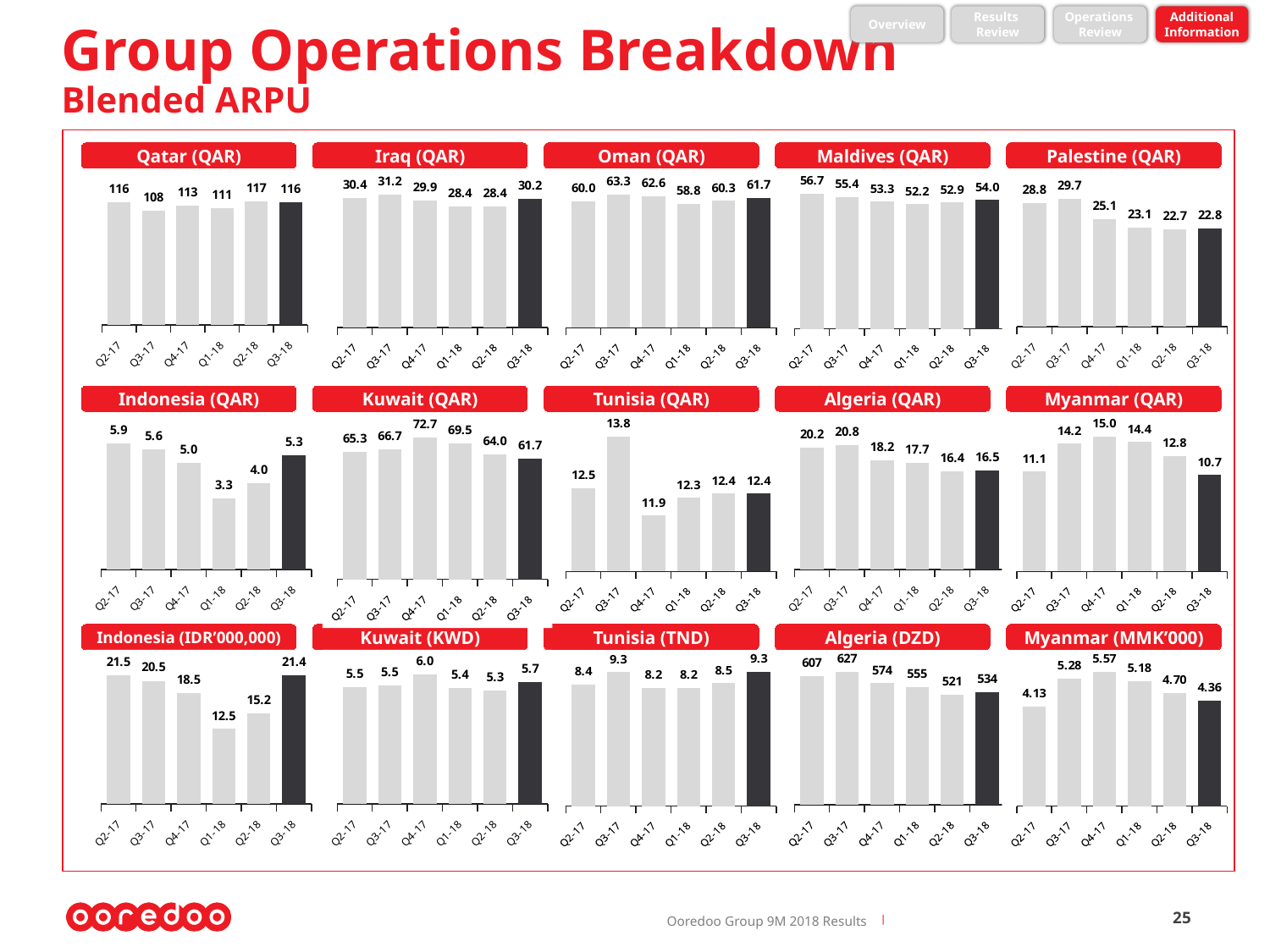
How many quarters are plotted in the Maldives (QAR) chart? 6 In the Tunisia (QAR) chart, what is the difference between the Q3-17 value and the Q4-17 value? 1.9 In the Indonesia (QAR) chart, which quarter has the lowest value? Q1-18 In the Qatar (QAR) chart, what is the value for Q2-18? 117 In the Myanmar (MMK'000) chart, what is the value for Q4-17? 5.57 What type of chart is the Oman (QAR) chart? bar chart In the Palestine (QAR) chart, is the value for Q3-17 larger or smaller than the value for Q3-18? larger In the Kuwait (QAR) chart, which quarter has the highest value? Q4-17 In the Algeria (DZD) chart, what is the difference between the Q3-17 value and the Q2-18 value? 106 In the Indonesia (IDR'000,000) chart, what is the value for Q3-18? 21.4 In the Algeria (QAR) chart, do the values generally rise or fall from Q2-17 to Q3-18? fall How many charts are shown on the slide? 15